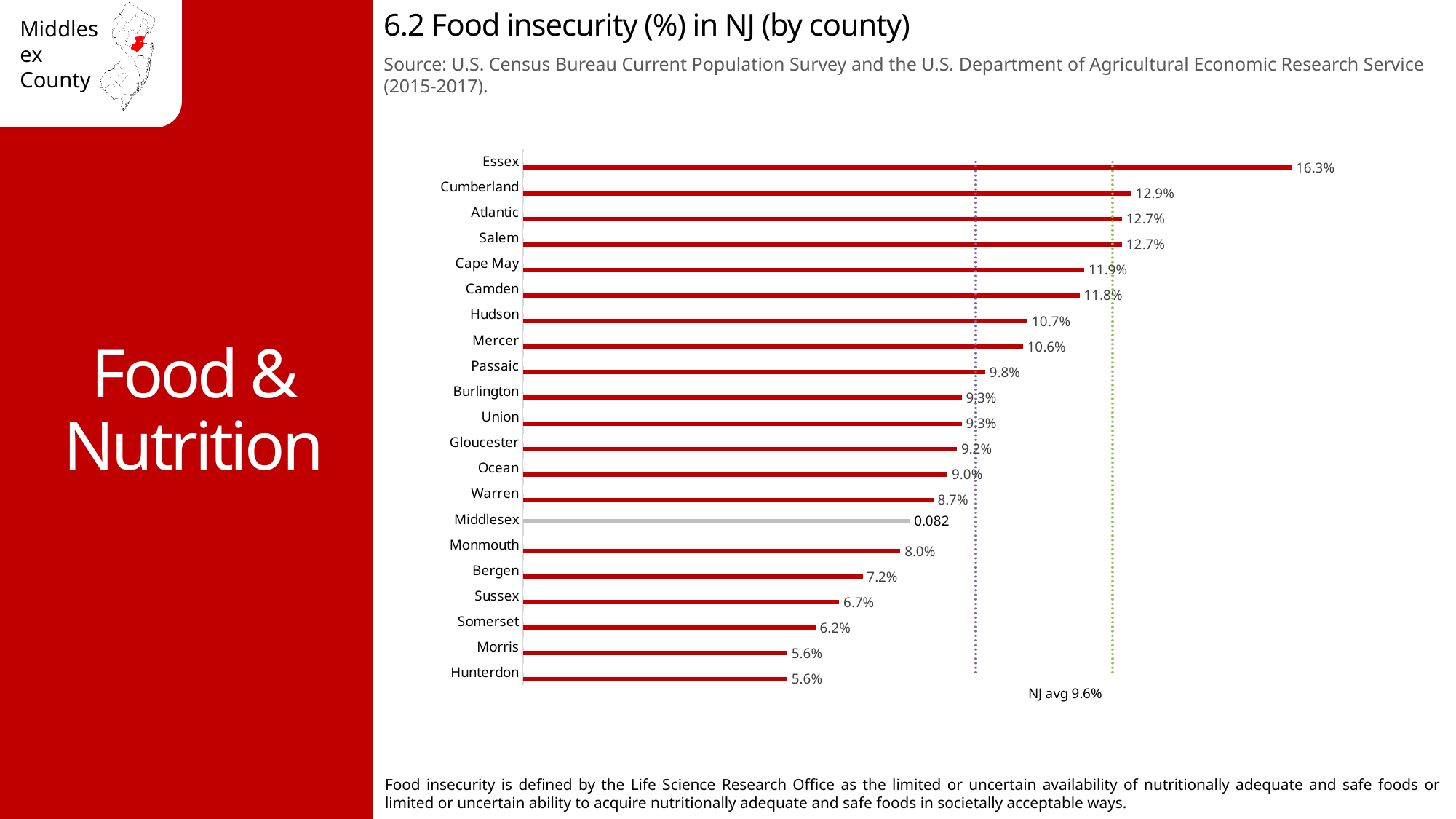
What NJ average value is noted on the chart? 9.6% What kind of chart is shown on the slide? Bar chart What value is printed next to the Middlesex bar? 0.082 How many counties are plotted in the chart? 21 Which county has the highest food insecurity percentage? Essex What is the food insecurity value shown for Somerset county? 6.2% What is the difference between the values for Monmouth and Bergen? 0.8% Which has a higher food insecurity value, Cape May or Passaic? Cape May Which has a lower food insecurity value, Sussex or Ocean? Sussex What is the food insecurity value shown for Camden county? 11.8% What is the food insecurity value shown for Essex county? 16.3% What is the difference between the values for Essex and Cumberland? 3.4%